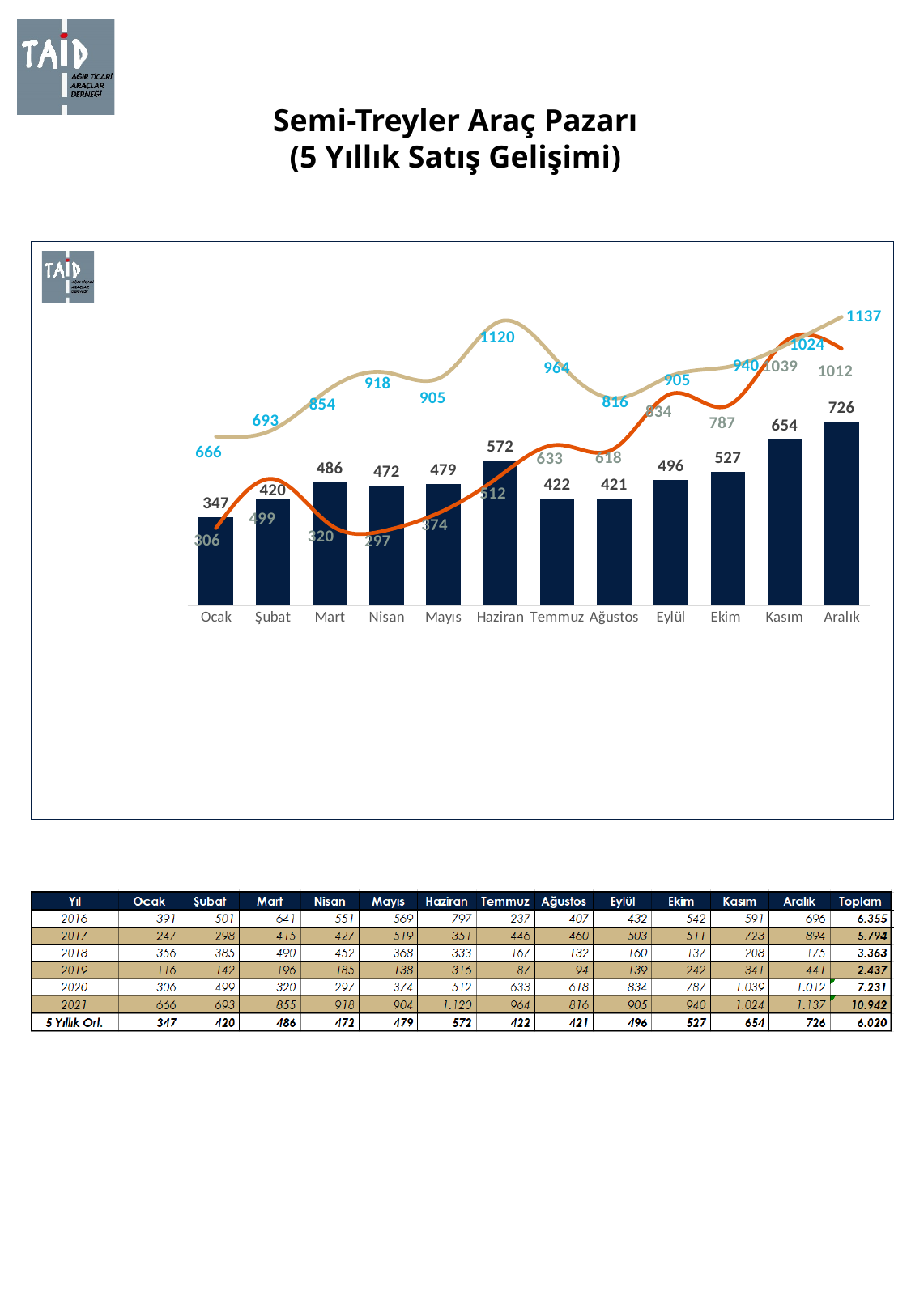
What is the difference between the bar values for Aralık and Kasım? 72 Which bar is taller, Mart or Nisan? Mart How many months are shown on the x axis? 12 Which month has the highest bar? Aralık Which month has the lowest bar? Ocak What is the highest value labelled on the light beige line? 1137 What is the value of the bar for Haziran? 572 What kind of chart is shown? combined bar and line chart Do the bar values generally rise or fall from Eylül to Aralık? rise What is the value labelled on the light beige line at Haziran? 1120 What is the value labelled on the orange line at Ocak? 306 What is the value of the bar for Ocak? 347